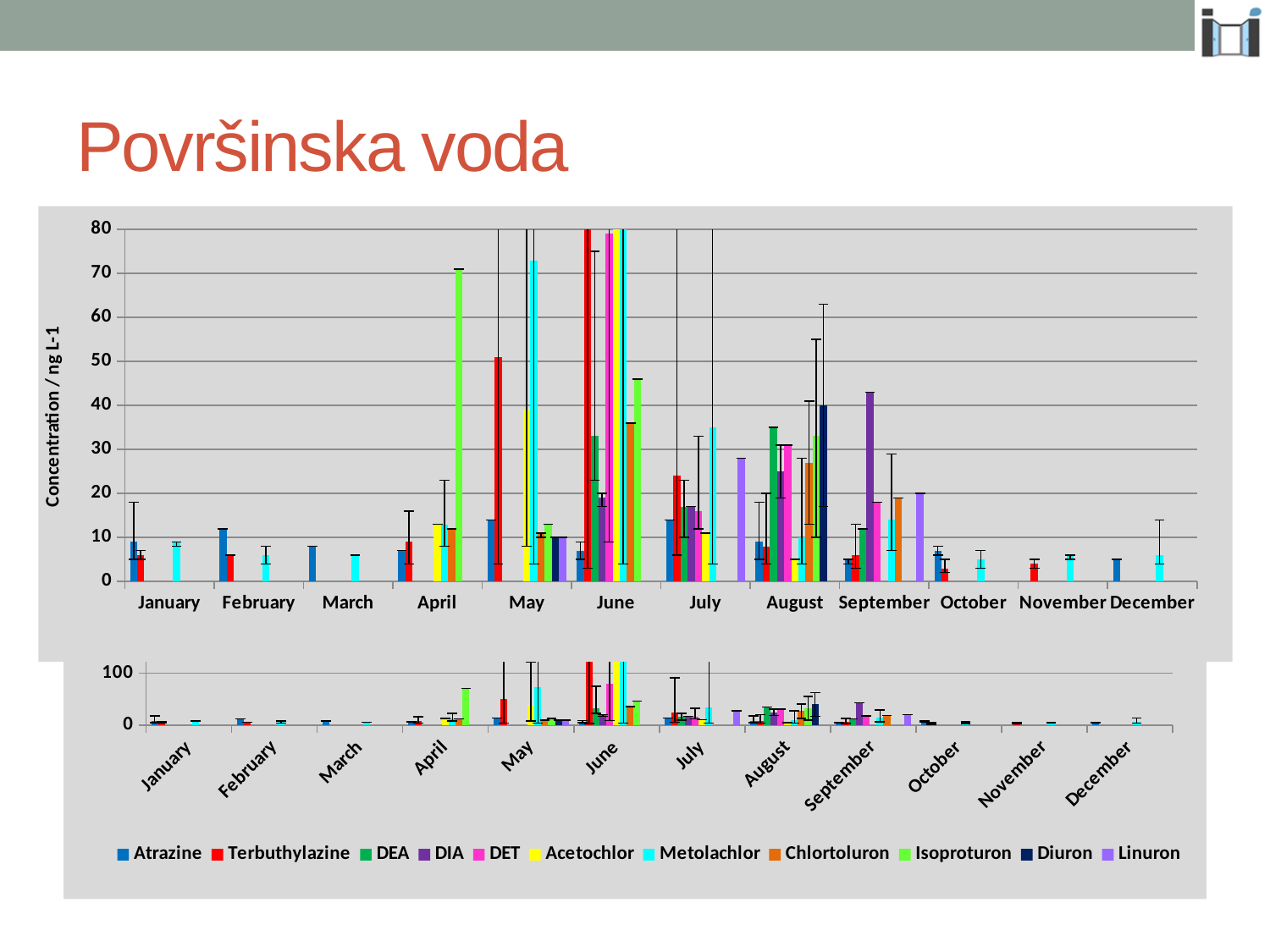
In the top chart, which is larger in April: Isoproturon or Acetochlor? Isoproturon In the top chart, which is larger in May: Terbuthylazine or Atrazine? Terbuthylazine In the top chart, is the value for Metolachlor in May greater or less than 60? greater What kind of chart is the top chart on the slide? bar chart In the top chart, is the value for Atrazine in February greater or less than 20? less What is the y-axis label of the top chart? Concentration / ng L-1 In the top chart, is the value for DIA in September greater or less than 30? greater In the top chart, which series has the highest value in September? DIA How many series does the legend at the bottom of the slide list? 11 How many months are shown along the x axis of the top chart? 12